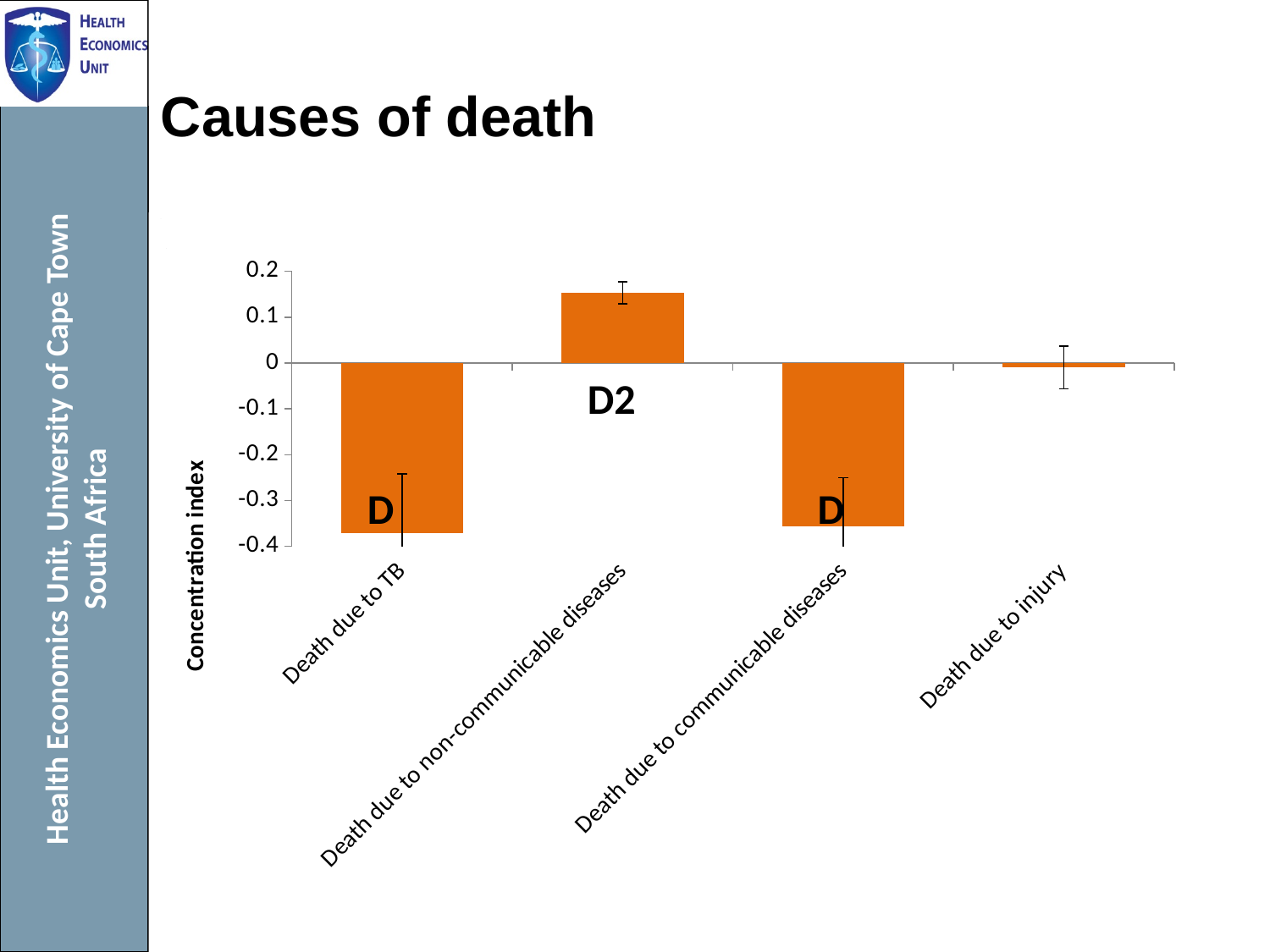
Which has the larger concentration index, Death due to TB or Death due to non-communicable diseases? Death due to non-communicable diseases Which has the larger concentration index, Death due to injury or Death due to communicable diseases? Death due to injury What is the title of the vertical axis? Concentration index Is the concentration index for Death due to TB greater or less than -0.3? less Is the concentration index for Death due to communicable diseases greater or less than -0.3? less How many of the bars have a negative concentration index? 3 Is the concentration index for Death due to injury greater or less than -0.1? greater How many causes of death are plotted on the chart? 4 What kind of chart is shown on the slide? bar chart What is the title of the slide? Causes of death Which cause of death has the highest concentration index? Death due to non-communicable diseases